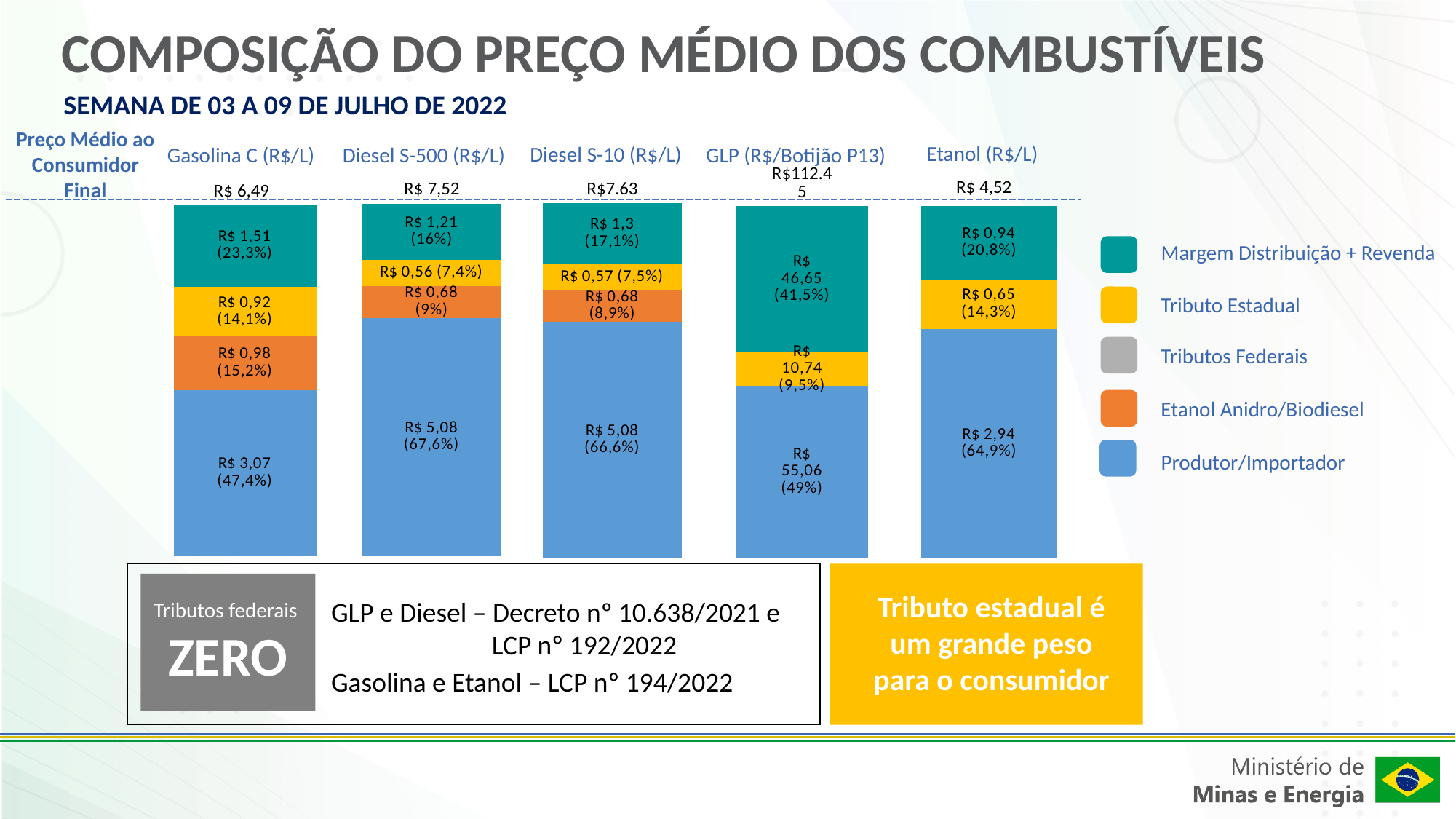
Which is larger, the Tributo Estadual for Diesel S-500 or for Diesel S-10? Diesel S-10 How many entries does the legend list? 5 What is the difference between the Margem Distribuição + Revenda values for Gasolina C and Etanol? R$ 0,57 What is the Margem Distribuição + Revenda value for GLP? R$ 46,65 What is the total Preço Médio ao Consumidor Final for Diesel S-500? R$ 7,52 What percentage of the Etanol price is Tributo Estadual? 14,3% How many fuel categories are shown in the chart? 5 Which fuel has the highest Preço Médio ao Consumidor Final? GLP What kind of chart is shown on the slide? Stacked bar chart Which fuel has the lowest Preço Médio ao Consumidor Final? Etanol What is the Produtor/Importador value for Gasolina C? R$ 3,07 Which colour represents Produtor/Importador in the chart? Blue